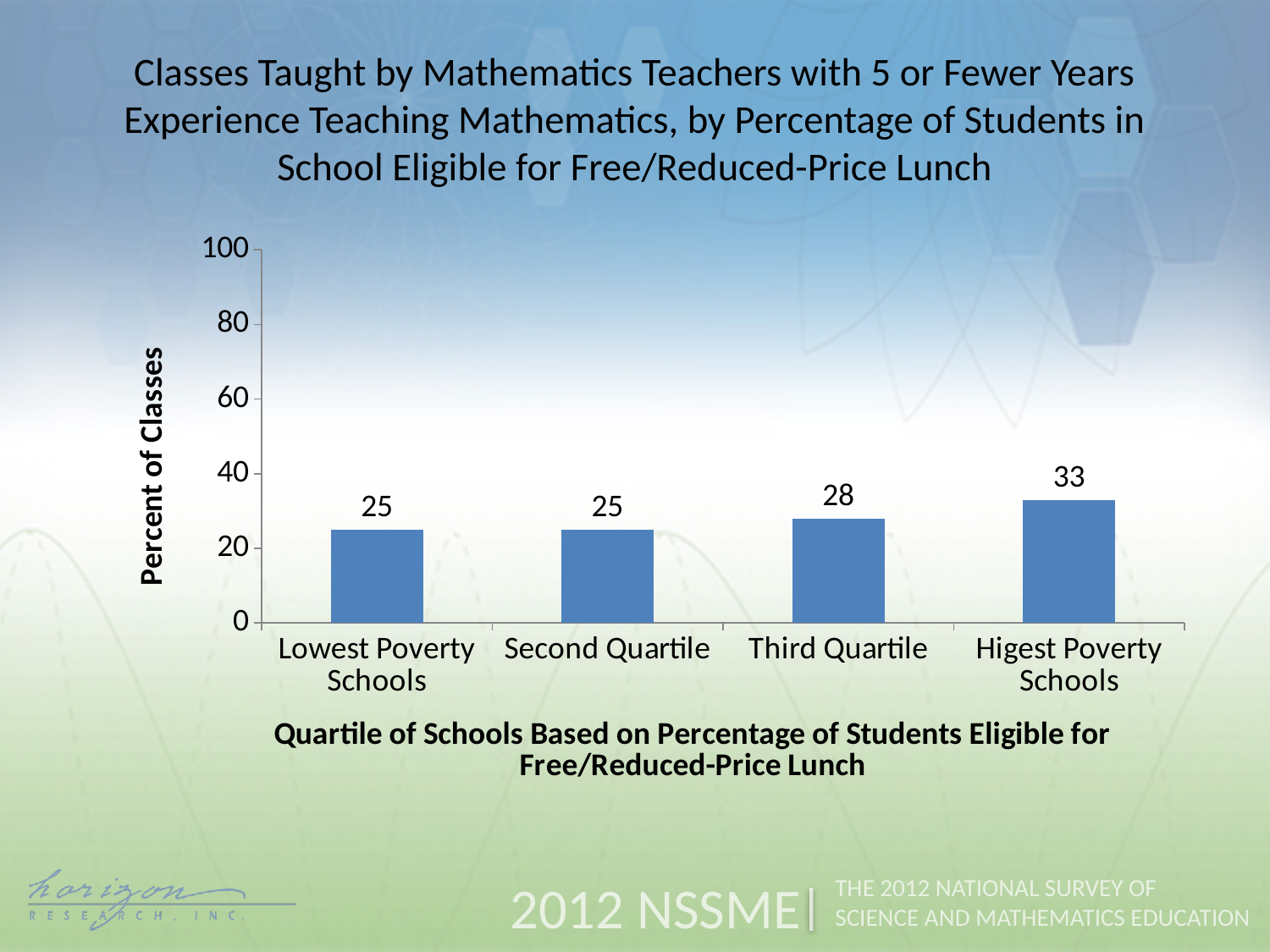
What kind of chart is shown on the slide? bar chart How many categories are shown on the x axis? 4 Which category has the highest value? Higest Poverty Schools What is the difference between the values for Highest Poverty Schools and Lowest Poverty Schools? 8 What is the value for Lowest Poverty Schools? 25 Which is larger, the value for Third Quartile or the value for Second Quartile? Third Quartile Is the value for Highest Poverty Schools greater or less than 40? less What is the value for Third Quartile? 28 What is the value for Highest Poverty Schools? 33 Do the values rise or fall from Lowest Poverty Schools to Highest Poverty Schools? rise What is the difference between the values for Third Quartile and Second Quartile? 3 What is the label of the y axis? Percent of Classes